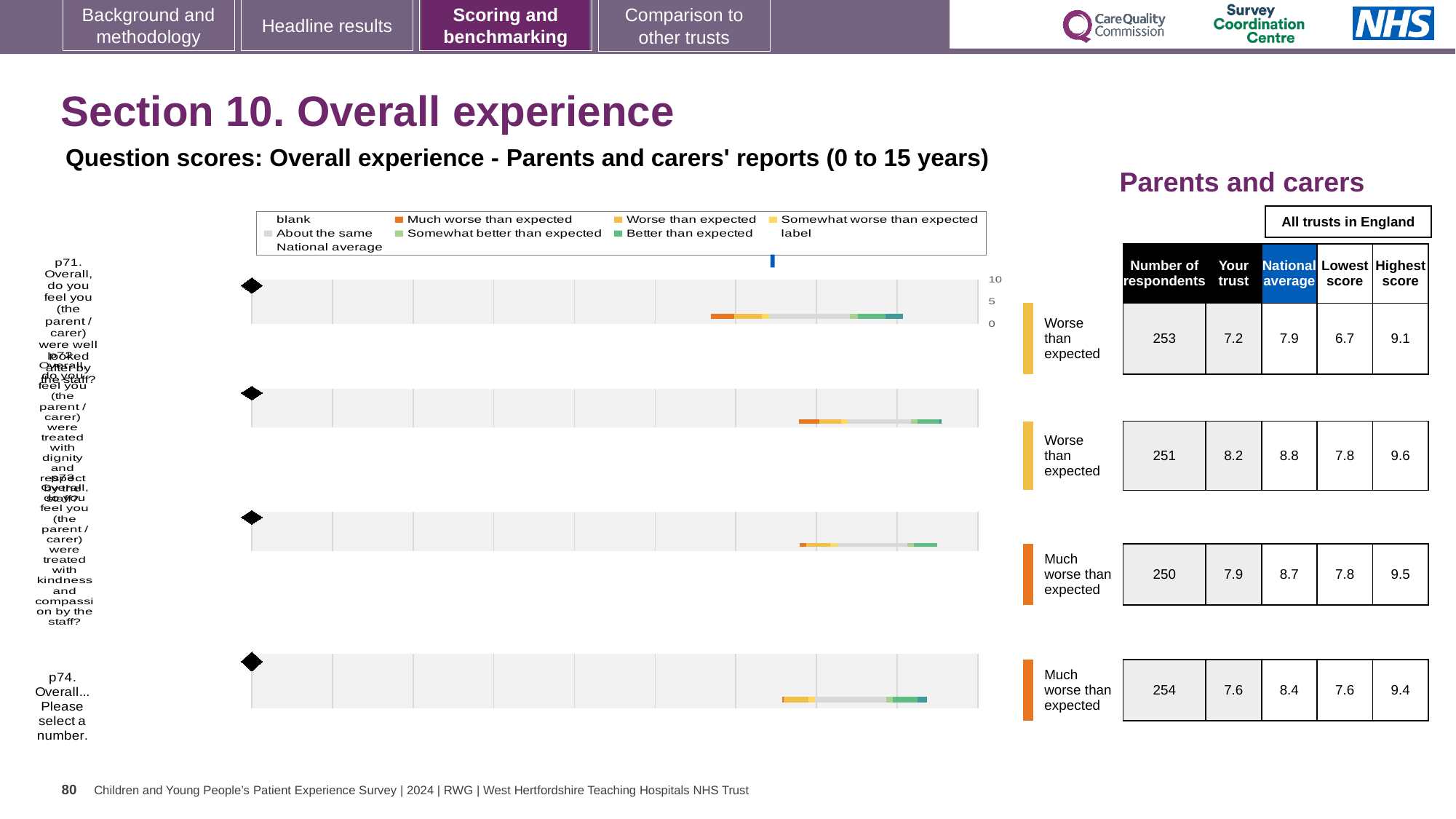
How many question rows (bars) does the chart show? 4 For p71, what is the difference between the national average and the 'Your trust' score? 0.7 Which benchmark category is shown for p71? Worse than expected Which benchmark category is shown for p74? Much worse than expected For p71, which is larger: the 'Your trust' score or the national average? National average What is the highest score across all trusts in England for p74? 9.4 What is the national average score for p74 (Overall... Please select a number)? 8.4 How many respondents answered p74 (Overall... Please select a number)? 254 What is the 'Your trust' score for p71 (Overall, do you feel you were well looked after by the staff?)? 7.2 What kind of chart is shown on the slide? bar chart What is the lowest value in the 'Lowest score' column? 6.7 What is the highest 'Your trust' score shown in the table? 8.2